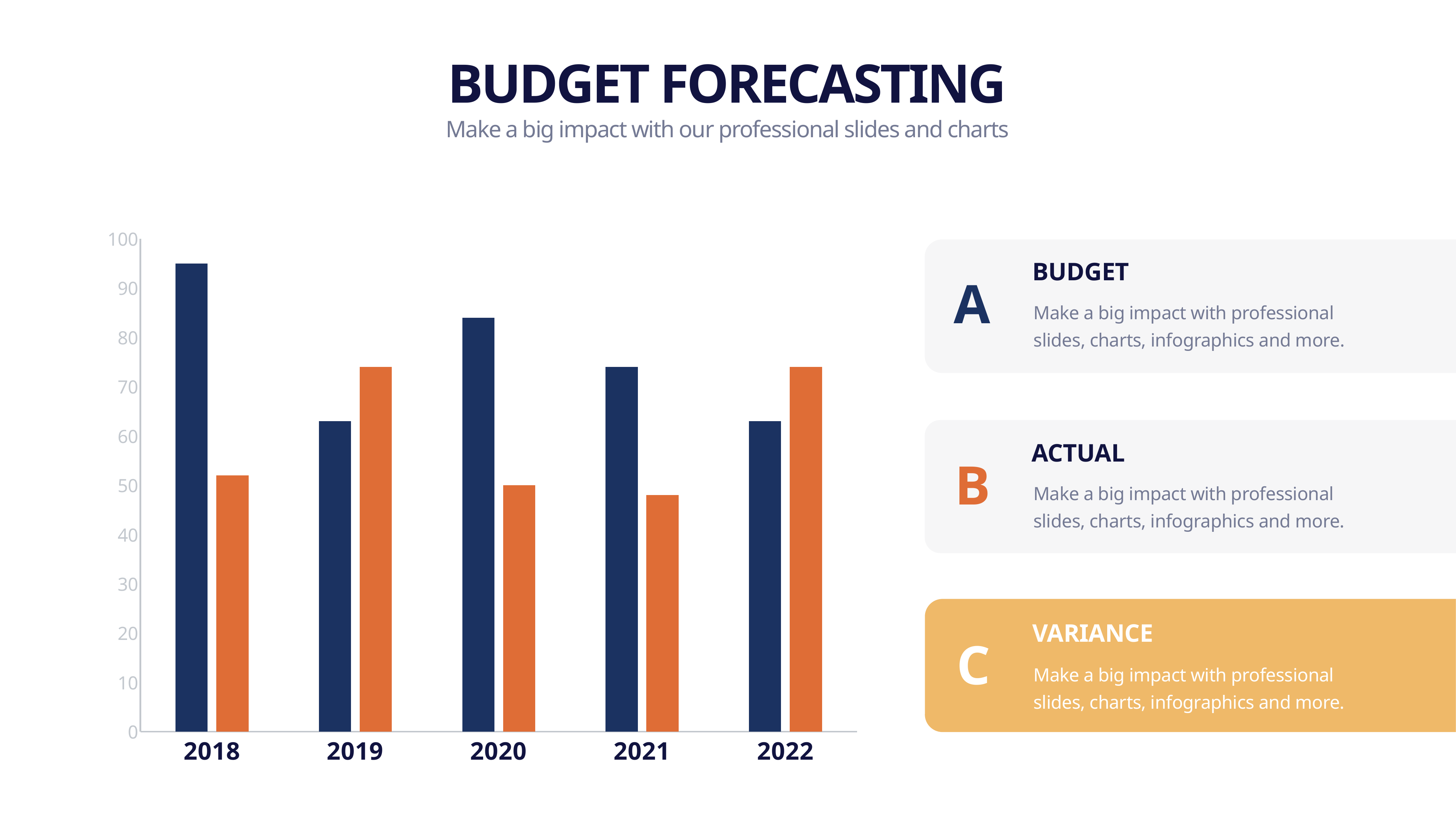
Is the dark blue (Budget) bar for 2018 greater or less than 90? greater In 2019, which bar is taller: the dark blue (Budget) bar or the orange (Actual) bar? orange (Actual) Is the orange (Actual) bar for 2018 greater or less than 60? less Is the orange (Actual) bar for 2021 greater or less than 60? less Which year has the tallest dark blue (Budget) bar? 2018 What is the title of the slide containing the chart? BUDGET FORECASTING In 2022, which bar is taller: the dark blue (Budget) bar or the orange (Actual) bar? orange (Actual) In 2018, which bar is taller: the dark blue (Budget) bar or the orange (Actual) bar? dark blue (Budget) What kind of chart is shown on the slide? bar chart How many years are shown on the x axis of the chart? 5